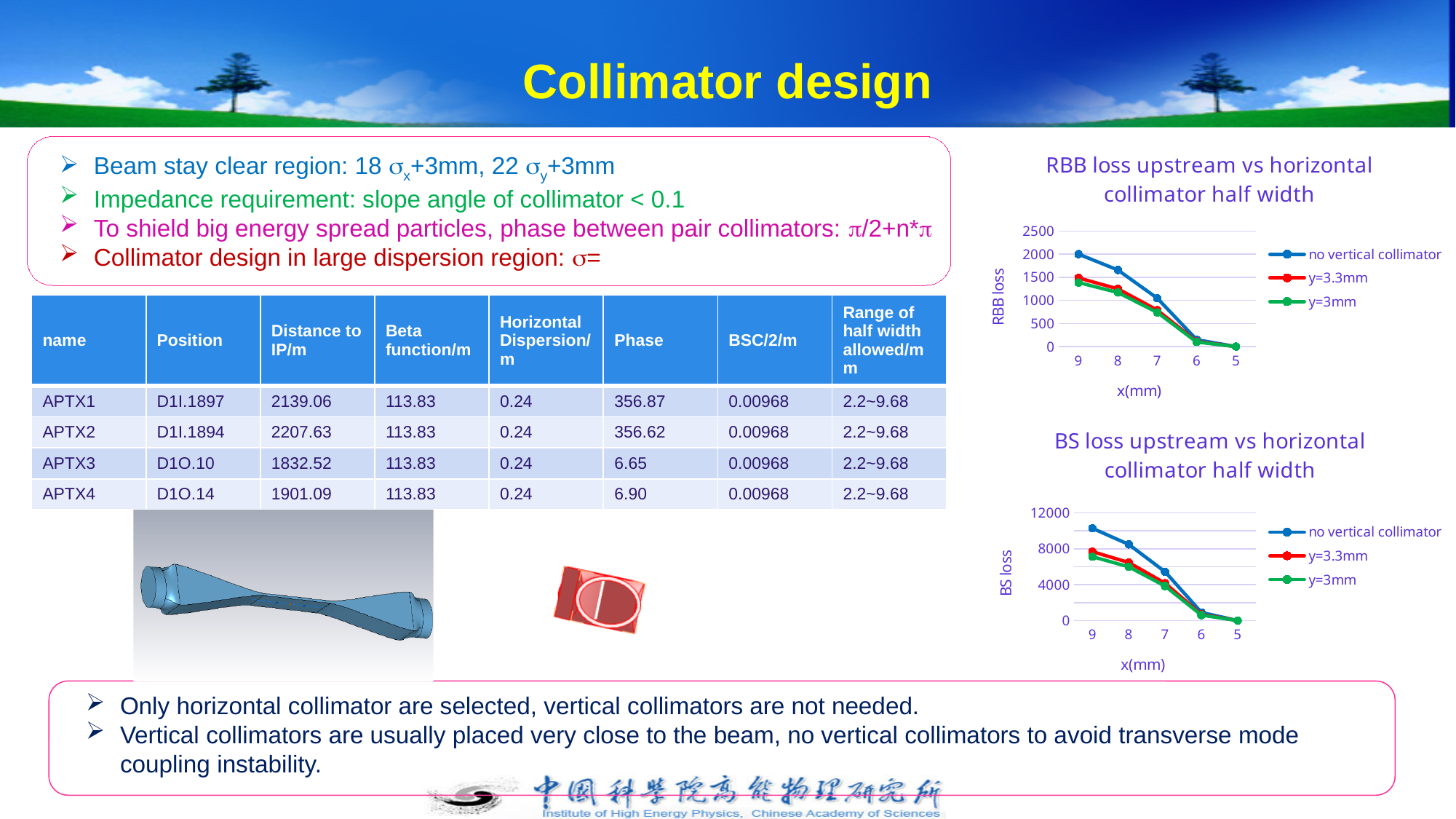
In the 'BS loss upstream vs horizontal collimator half width' chart, do the values of 'no vertical collimator' rise or fall moving left to right along the x axis from 9 to 5? fall What is the label of the vertical axis in the 'RBB loss upstream vs horizontal collimator half width' chart? RBB loss What kind of chart is the 'RBB loss upstream vs horizontal collimator half width' chart? line chart In the 'RBB loss upstream vs horizontal collimator half width' chart, is the value for 'y=3mm' at x=7 greater or less than 1000? less In the 'BS loss upstream vs horizontal collimator half width' chart, which series has the highest value at x=9? no vertical collimator In the 'RBB loss upstream vs horizontal collimator half width' chart, is the value for 'no vertical collimator' at x=8 greater or less than 1500? greater In the 'BS loss upstream vs horizontal collimator half width' chart, is the value for 'y=3.3mm' at x=7 greater or less than 8000? less How many series does the legend of the 'BS loss upstream vs horizontal collimator half width' chart list? 3 In the 'RBB loss upstream vs horizontal collimator half width' chart, which is larger at x=9: 'no vertical collimator' or 'y=3mm'? no vertical collimator How many x(mm) points are plotted for each series in the 'RBB loss upstream vs horizontal collimator half width' chart? 5 What is the label of the horizontal axis in the 'BS loss upstream vs horizontal collimator half width' chart? x(mm)